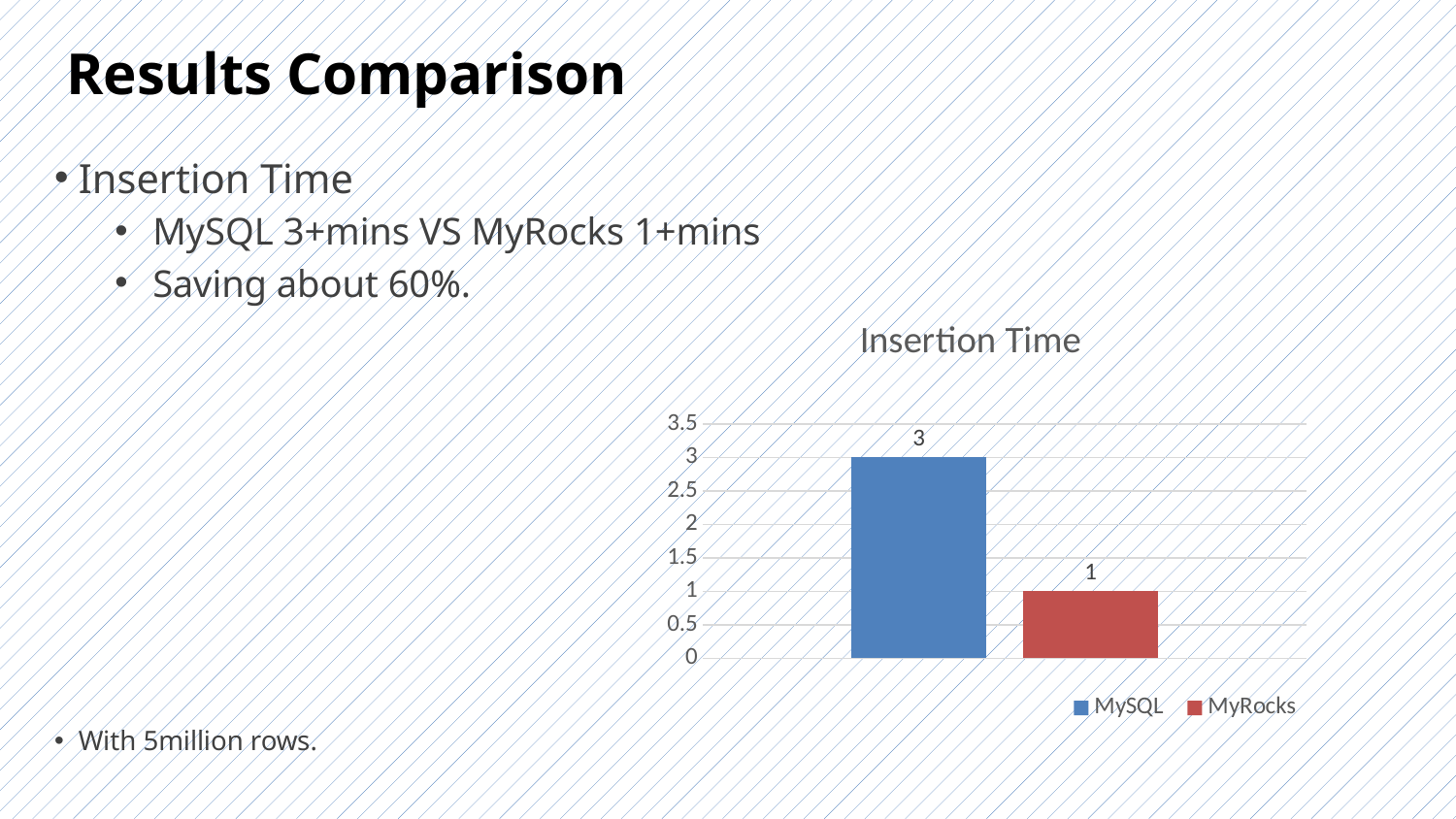
What is the value for MySQL in the Insertion Time chart? 3 How many bars are plotted in the Insertion Time chart? 2 Which series has the lowest value in the Insertion Time chart? MyRocks What is the value for MyRocks in the Insertion Time chart? 1 What is the difference between the MySQL and MyRocks values in the Insertion Time chart? 2 Which is larger in the Insertion Time chart, MySQL or MyRocks? MySQL How many series does the legend of the Insertion Time chart list? 2 Is the value for MyRocks greater or less than 2? less Is the value for MySQL greater or less than 2? greater What is the title of the chart on the slide? Insertion Time Which series has the highest value in the Insertion Time chart? MySQL What kind of chart is shown on the slide? Bar chart